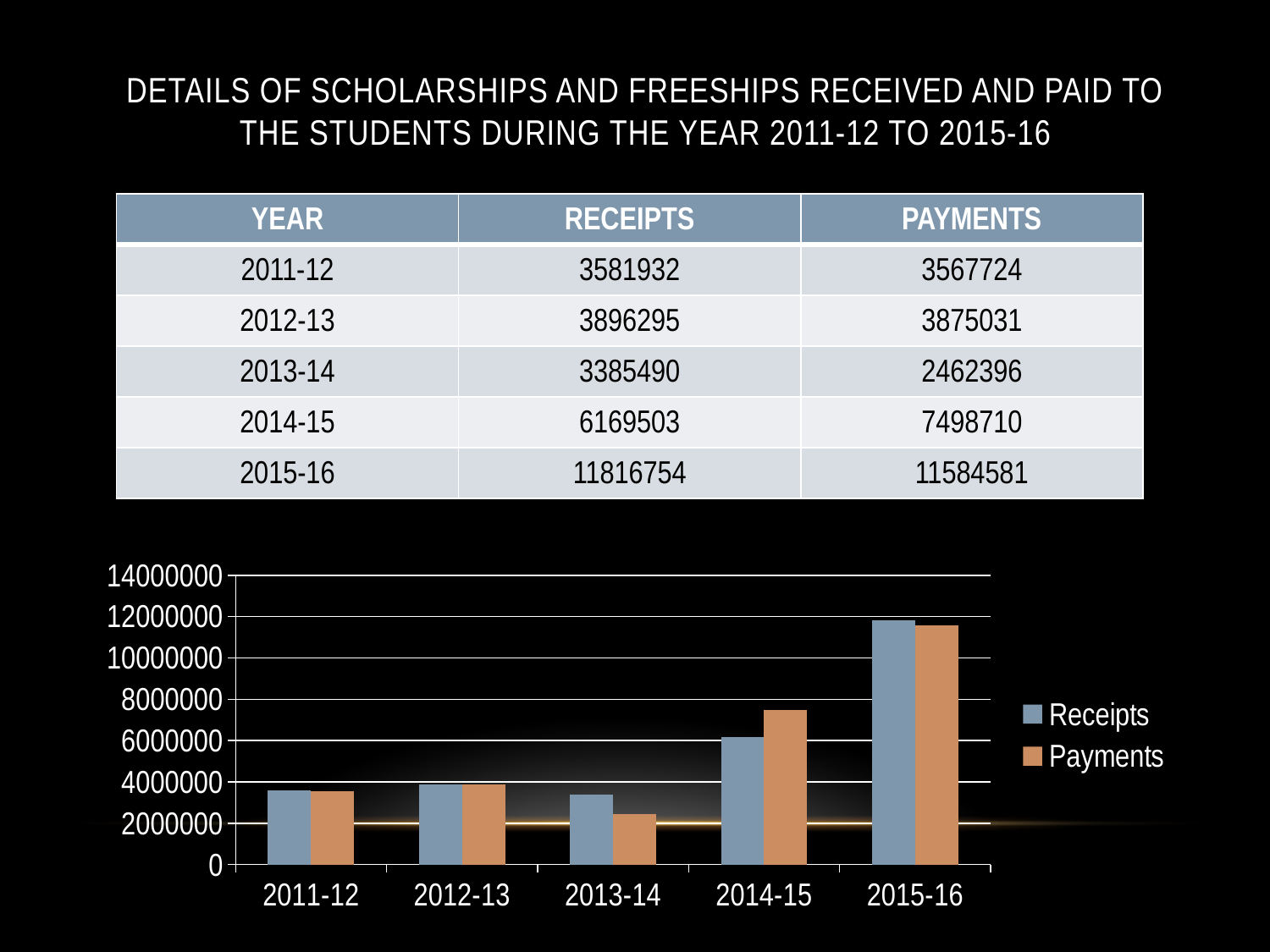
Is the Payments value for 2014-15 greater or less than 6000000? greater How many series does the chart's legend list? 2 In 2013-14, which is larger, Receipts or Payments? Receipts What kind of chart is shown on the slide? bar chart Which colour represents Payments in the chart's legend? orange Do the Receipts values generally rise or fall from 2013-14 to 2015-16? rise What is the Payments value for 2013-14? 2462396 How many year categories are shown on the chart's x axis? 5 What is the difference between Receipts and Payments in 2014-15? 1329207 Which year has the highest Receipts value? 2015-16 Which year has the lowest Payments value? 2013-14 What is the Receipts value for 2015-16? 11816754